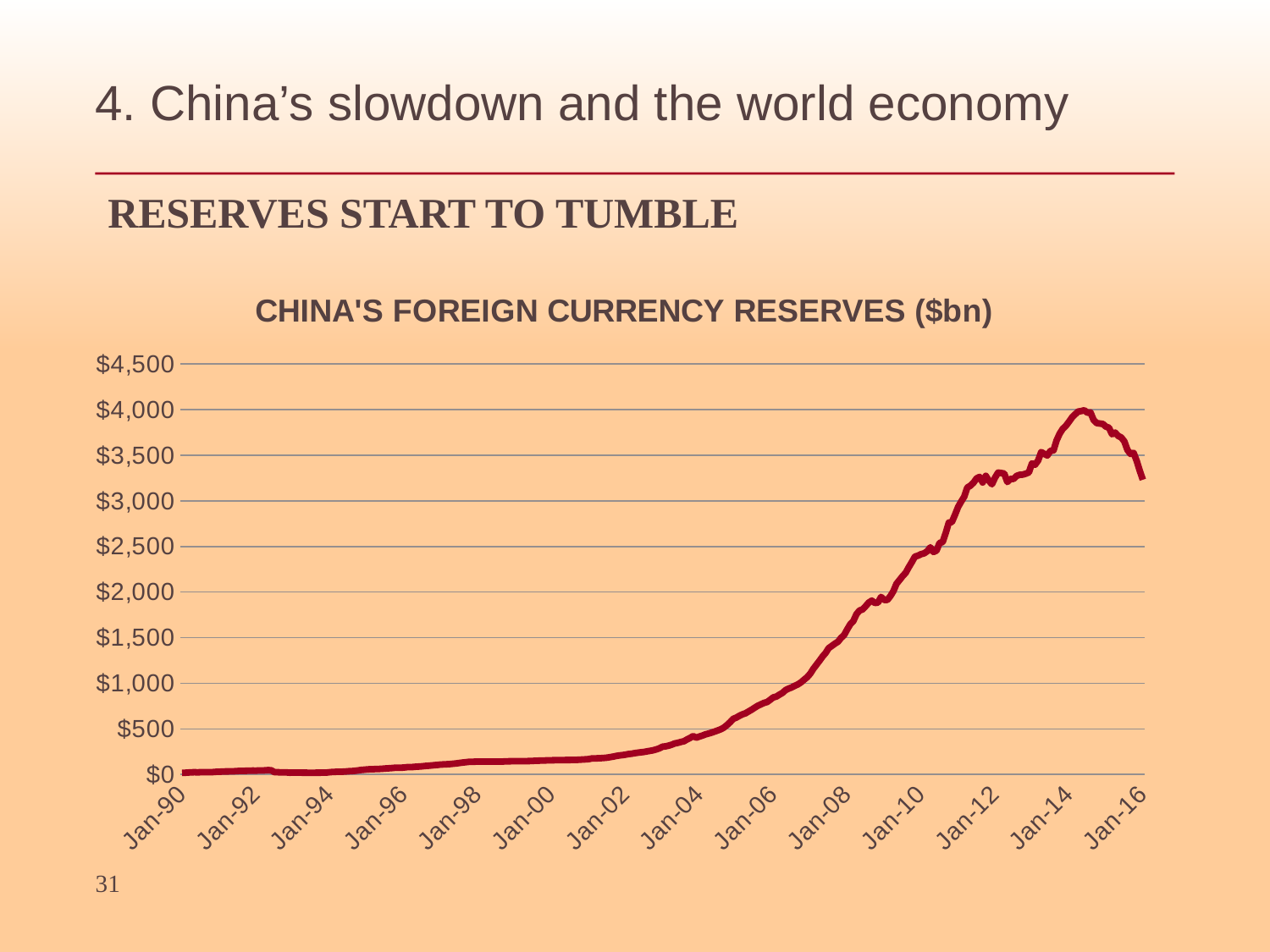
How many date labels are shown on the x axis? 14 What is the title of the chart? CHINA'S FOREIGN CURRENCY RESERVES ($bn) Is the value at Jan-14 greater or less than $3,500? greater Do the reserves rise or fall between Jan-14 and Jan-16? Fall Do the reserves generally rise or fall between Jan-90 and Jan-14? Rise Is the value at Jan-04 greater or less than $500? less What kind of chart is shown on the slide? Line chart Is the value at Jan-06 greater or less than $1,000? less In what unit are the reserves measured, according to the chart title? $bn